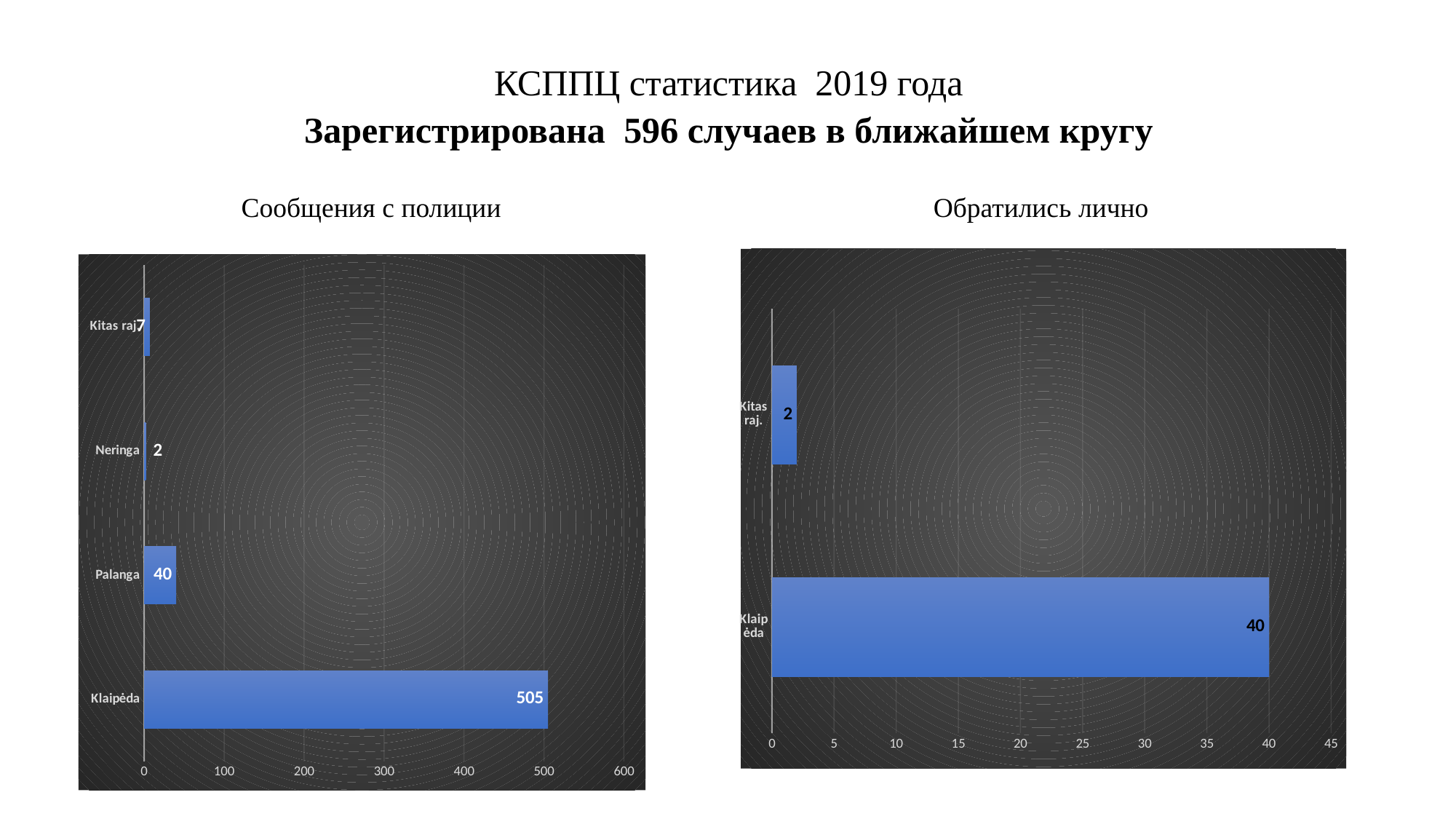
In the left chart (Сообщения с полиции), what is the value for Klaipėda? 505 In the left chart (Сообщения с полиции), what is the value for Neringa? 2 In the right chart (Обратились лично), what is the difference between the values for Klaipėda and Kitas raj.? 38 In the left chart (Сообщения с полиции), what is the value for Palanga? 40 In the right chart (Обратились лично), what is the value for Klaipėda? 40 In the right chart (Обратились лично), what is the value for Kitas raj.? 2 In the left chart (Сообщения с полиции), which category has the lowest value? Neringa What type of chart is the right chart (Обратились лично)? Bar chart In the left chart (Сообщения с полиции), what is the difference between the values for Klaipėda and Palanga? 465 In the left chart (Сообщения с полиции), what is the value for Kitas raj? 7 In the left chart (Сообщения с полиции), how many categories are shown? 4 In the left chart (Сообщения с полиции), which category has the highest value? Klaipėda